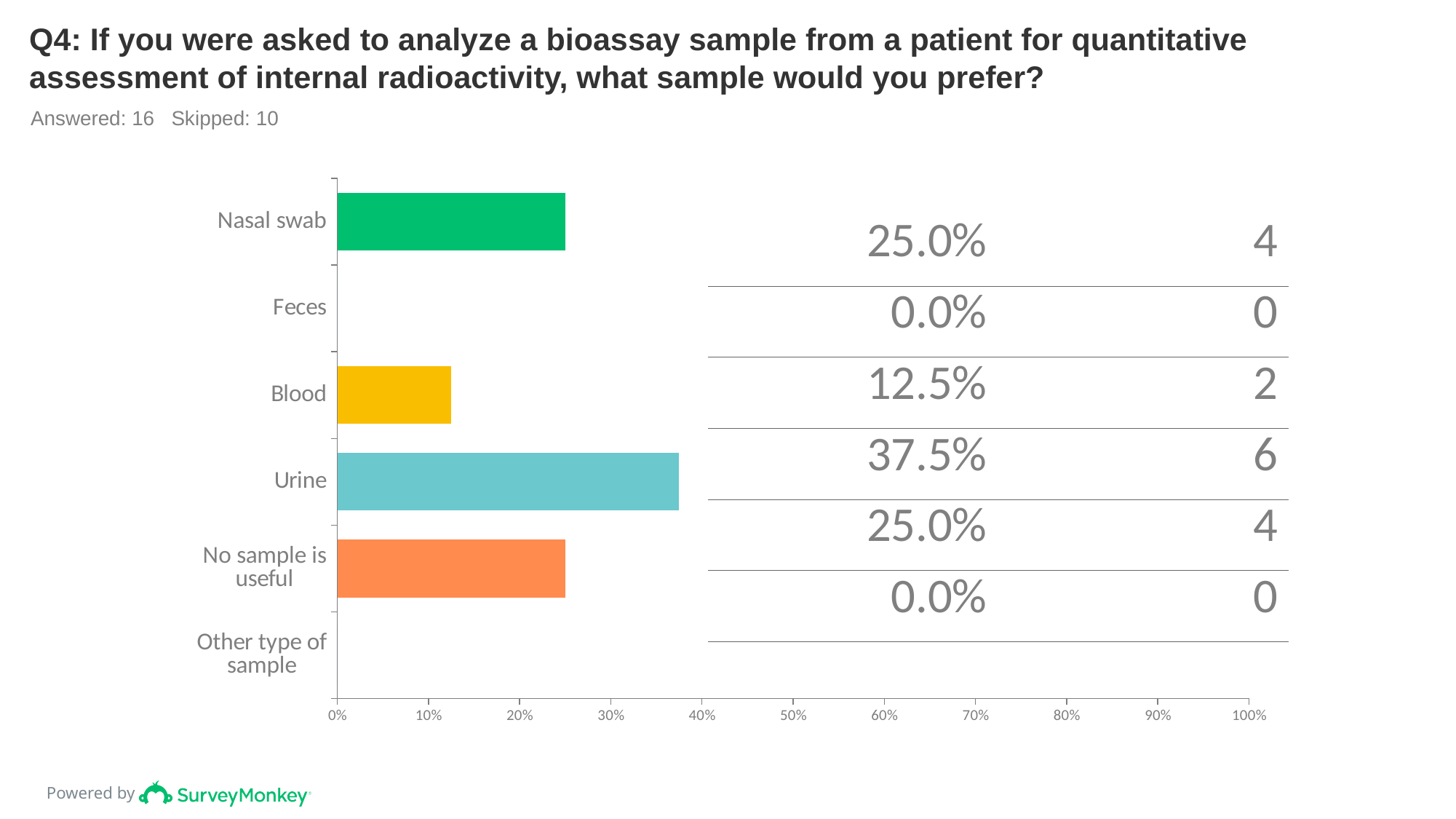
Which sample type received the highest percentage of responses? Urine Is the value for Urine greater or less than 30%? greater How many answer categories are shown on the chart? 6 What percentage of respondents chose Nasal swab? 25.0% What colour is the bar for Urine? Light blue How many respondents answered this question? 16 Which received more responses, Nasal swab or Blood? Nasal swab How many respondents chose Feces? 0 What percentage of respondents preferred Urine as the sample? 37.5% What is the difference in percentage points between Urine and Blood? 25.0% What kind of chart is shown on the slide? Bar chart How many respondents chose Blood? 2